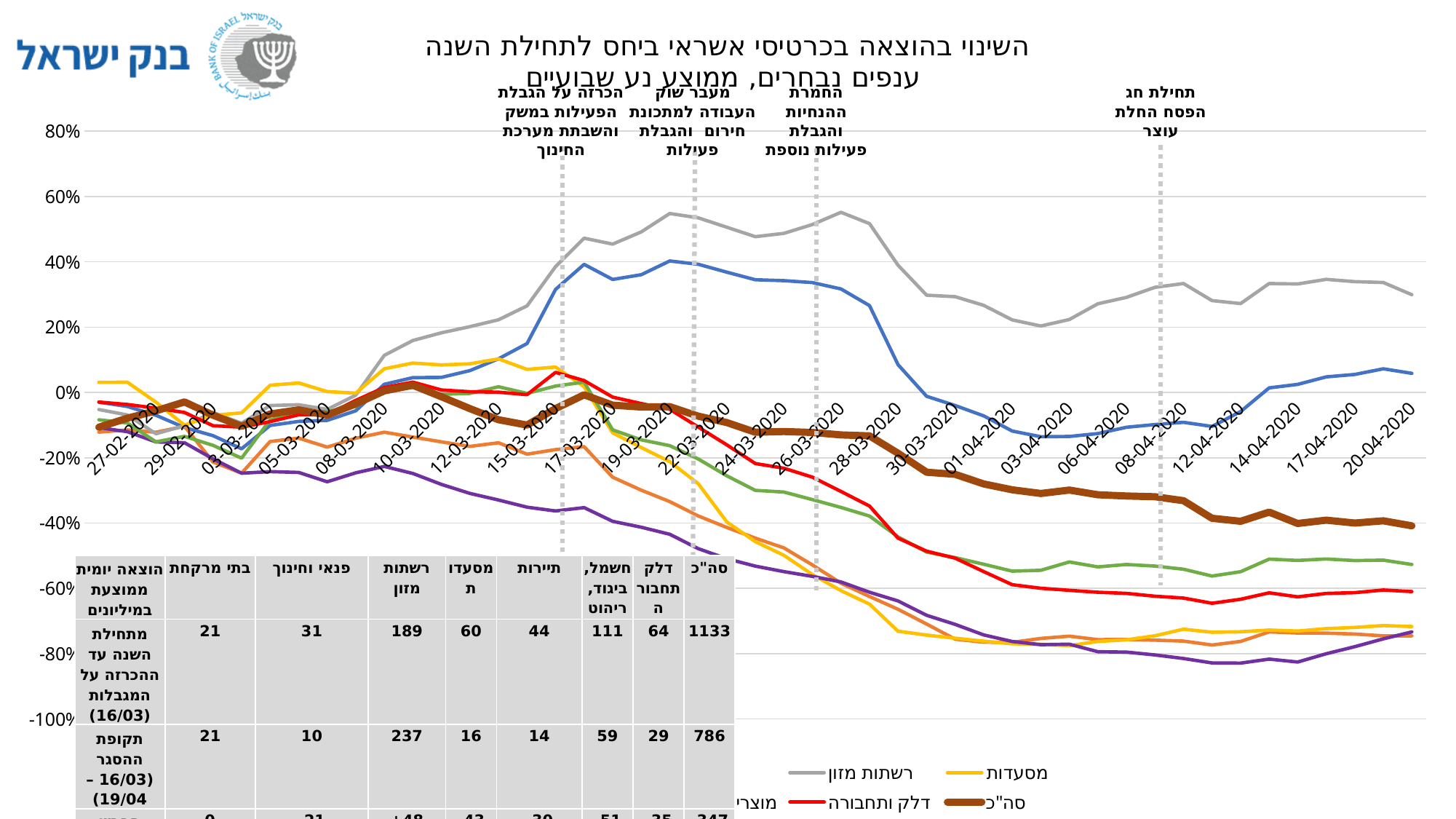
What kind of chart is shown on the slide? line chart On 20-04-2020, which is higher: רשתות מזון or סה"כ? רשתות מזון Is the value for דלק ותחבורה on 20-04-2020 greater or less than -40%? less Is the value for מסעדות on 20-04-2020 greater or less than -60%? less Is the value for סה"כ on 20-04-2020 greater or less than -20%? less What colour is the סה"כ line in the chart? brown Which series has the highest value on 20-04-2020? רשתות מזון Does the סה"כ line rise or fall between 17-03-2020 and 20-04-2020? fall On 20-04-2020, which is higher: דלק ותחבורה or מסעדות? דלק ותחבורה